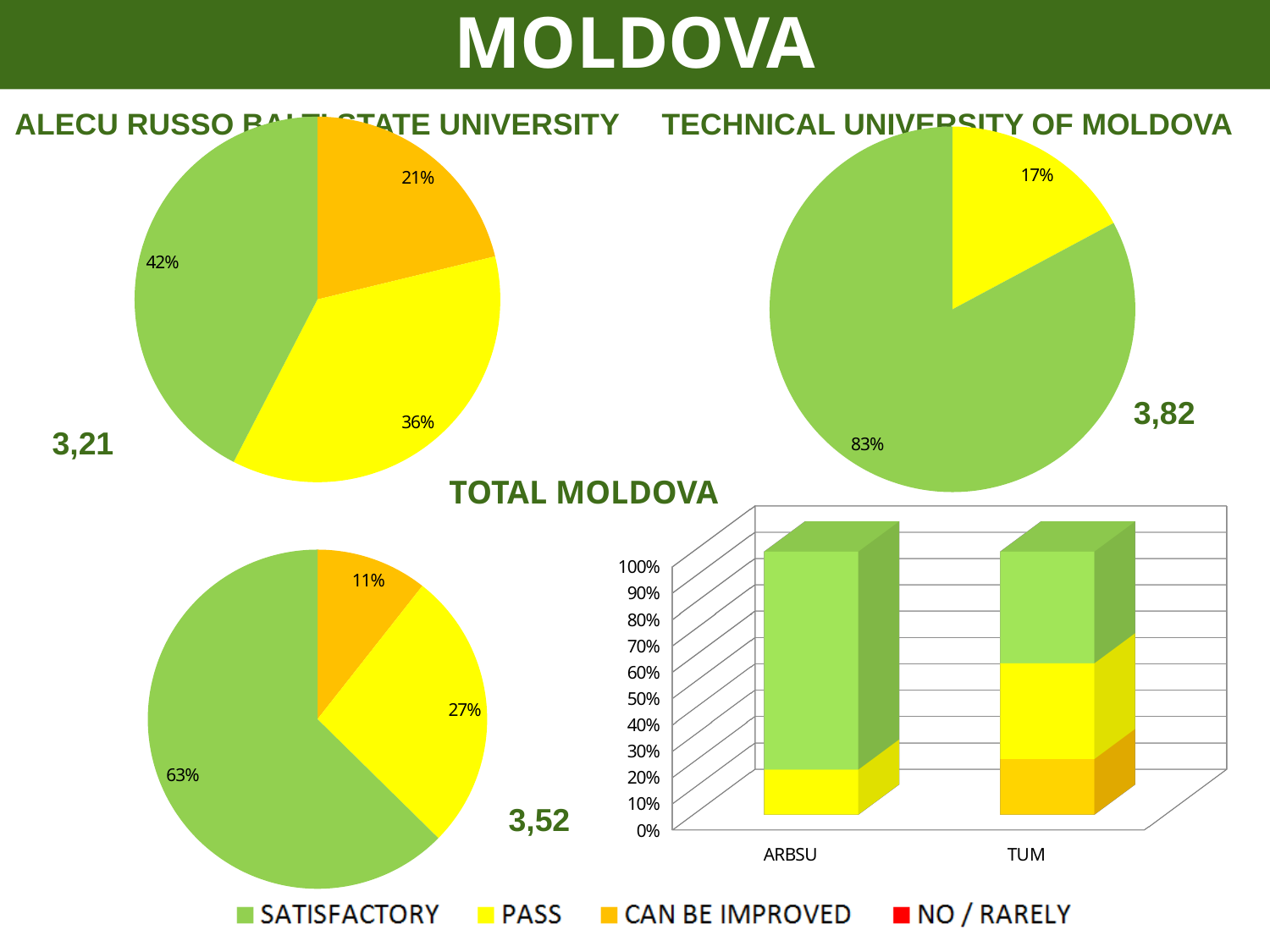
How many categories are shown on the x axis of the stacked bar chart at the bottom right? 2 How many slices does the Technical University of Moldova pie chart have? 2 In the Total Moldova pie chart, what is the difference between the 27% slice and the 11% slice? 16% How many entries does the legend at the bottom of the slide list? 4 In the Alecu Russo Balti State University pie chart, what is the difference between the 42% slice and the 36% slice? 6% In the Total Moldova pie chart, which slice is the smallest? Can be improved (orange, 11%) In the Alecu Russo Balti State University pie chart, what share is labelled for the largest (green) slice? 42% In the Alecu Russo Balti State University pie chart, what percentage is shown for the orange slice? 21% In the Technical University of Moldova pie chart, which slice is the largest? Satisfactory (green, 83%) In the Total Moldova pie chart, what percentage is shown for the green slice? 63% What kind of chart is the chart at the bottom right with ARBSU and TUM on the x axis? Stacked bar chart In the Technical University of Moldova pie chart, what percentage is shown for the yellow slice? 17%